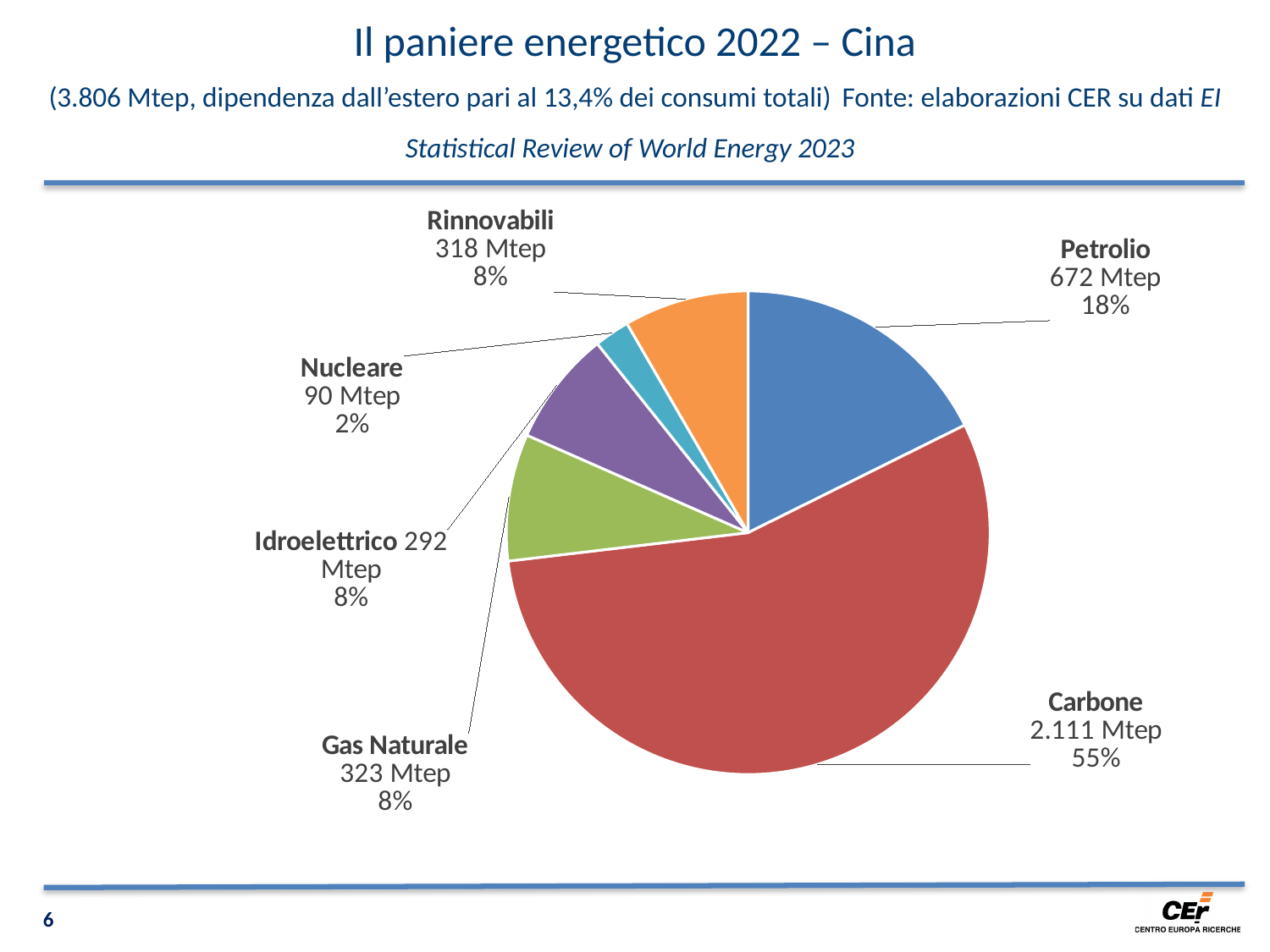
What is the value for Carbone? 2.111 Mtep What is the value for Petrolio? 672 Mtep How many slices does the pie chart have? 6 What is the value for Gas Naturale? 323 Mtep What is the difference in Mtep between Gas Naturale and Rinnovabili? 5 Mtep What share of the pie does Carbone represent? 55% What share of the pie does Petrolio represent? 18% Which category has the largest slice of the pie? Carbone What kind of chart is shown on the slide? pie chart What is the value for Nucleare? 90 Mtep Which is larger, Idroelettrico or Petrolio? Petrolio Which category has the smallest slice of the pie? Nucleare